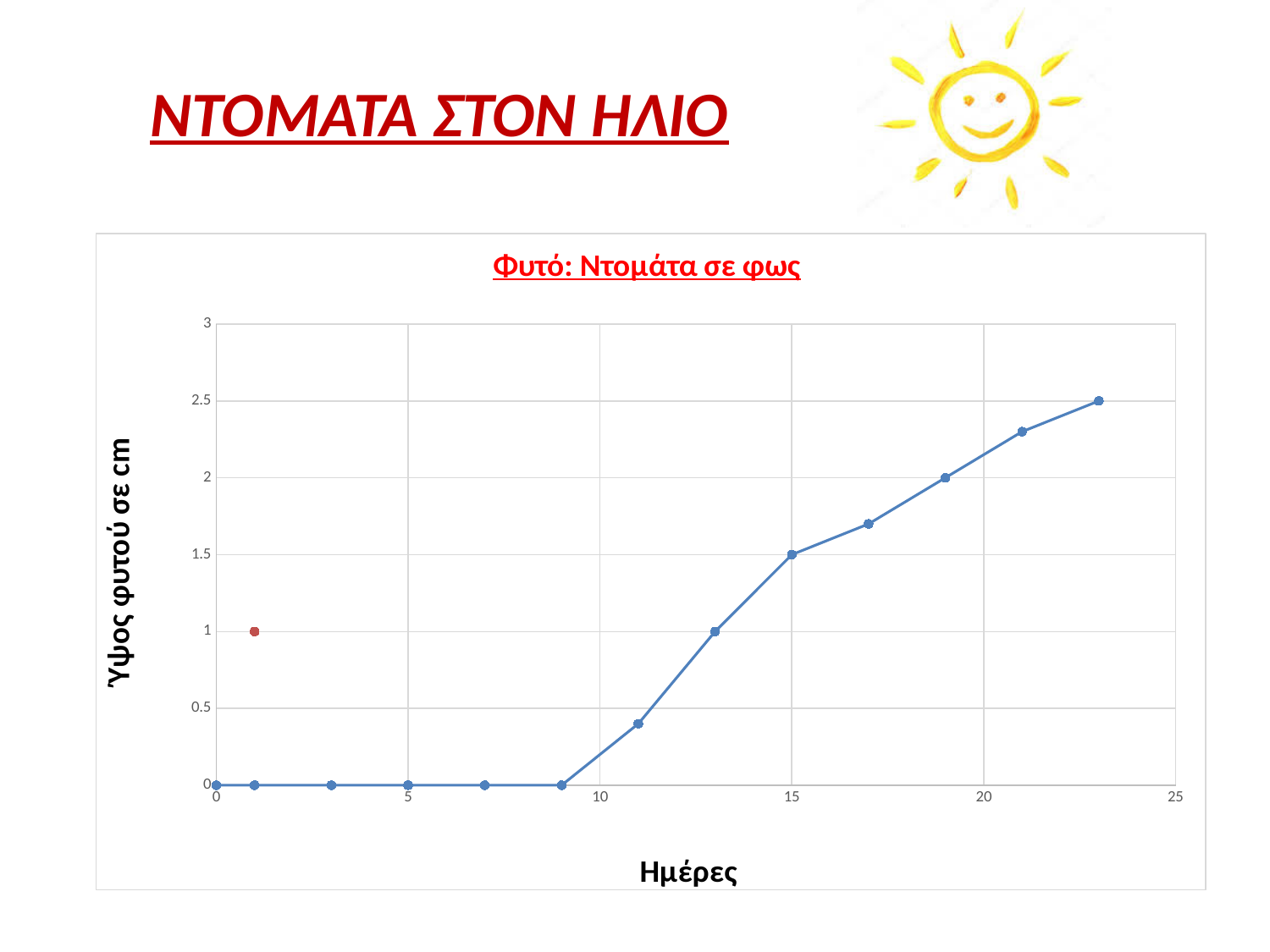
How many blue data points are plotted on the line? 13 What is the label of the vertical axis? Ύψος φυτού σε cm Is the final plotted plant height greater or less than 2? greater Which is larger, the plant height at day 15 or at day 5? day 15 What is the plant height at day 15? 1.5 What is the difference between the plant height at day 15 and at day 5? 1.5 What is the plant height at day 5? 0 What is the lowest plant height shown on the chart? 0 What kind of chart is shown on the slide? line chart What is the title of the chart? Φυτό: Ντομάτα σε φως Does the plant height rise or fall as the days increase? rise What is the highest plant height reached on the chart? 2.5